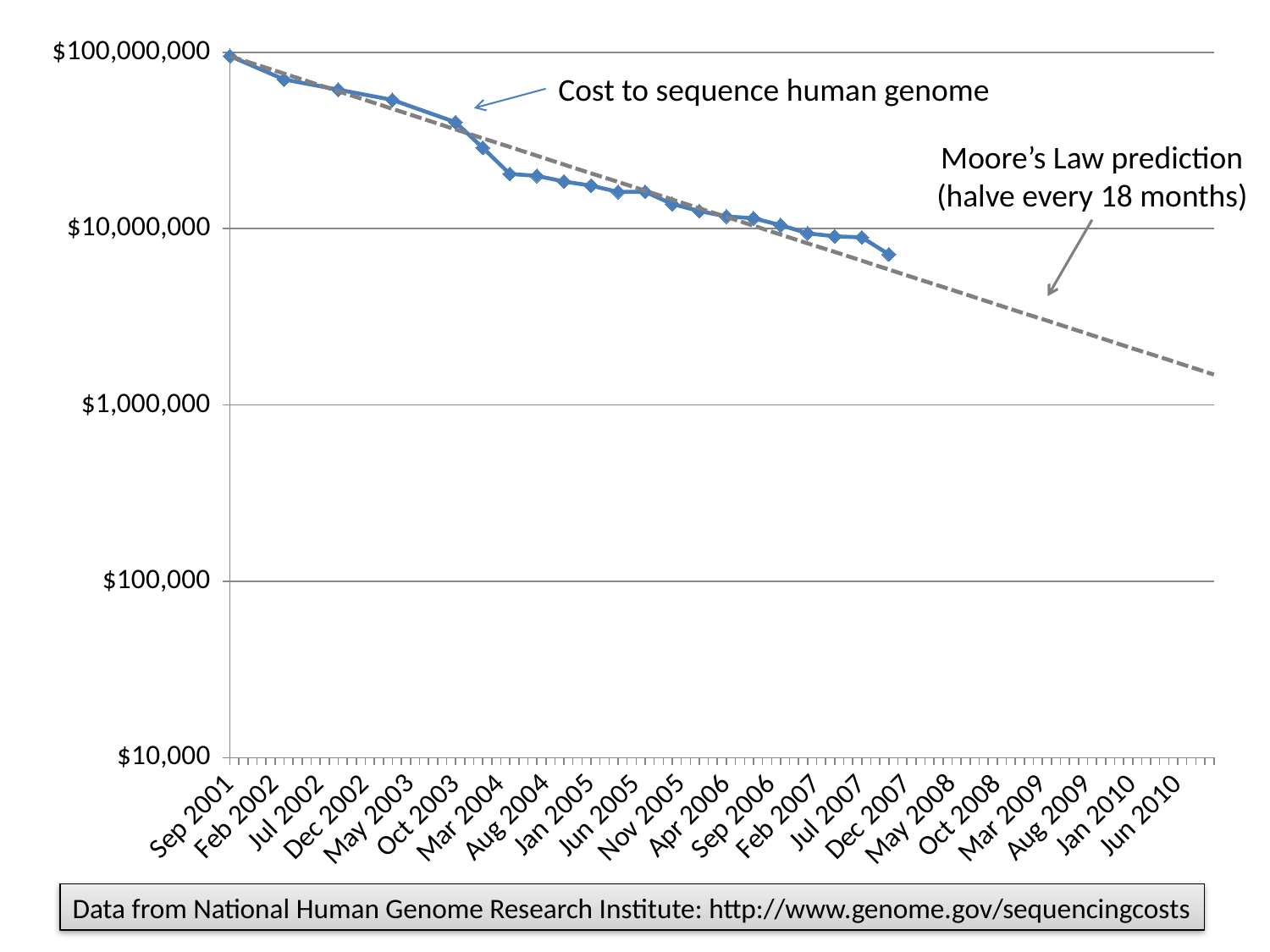
Is the cost to sequence a human genome in Mar 2004 greater or less than $10,000,000? greater Is the Moore's Law prediction at Jun 2010 greater or less than $1,000,000? greater What is the lowest value shown on the y axis? $10,000 Is the cost to sequence a human genome at the last plotted point (Dec 2007) greater or less than $10,000,000? less How many lines are plotted on the chart? 2 Which is larger: the cost to sequence a human genome in Sep 2001 or in Dec 2007? Sep 2001 What does the dashed line on the chart represent? Moore's Law prediction (halve every 18 months) What kind of chart is shown on the slide? line chart Which date has the highest cost to sequence a human genome? Sep 2001 Does the cost to sequence a human genome rise or fall over time along the x axis? fall